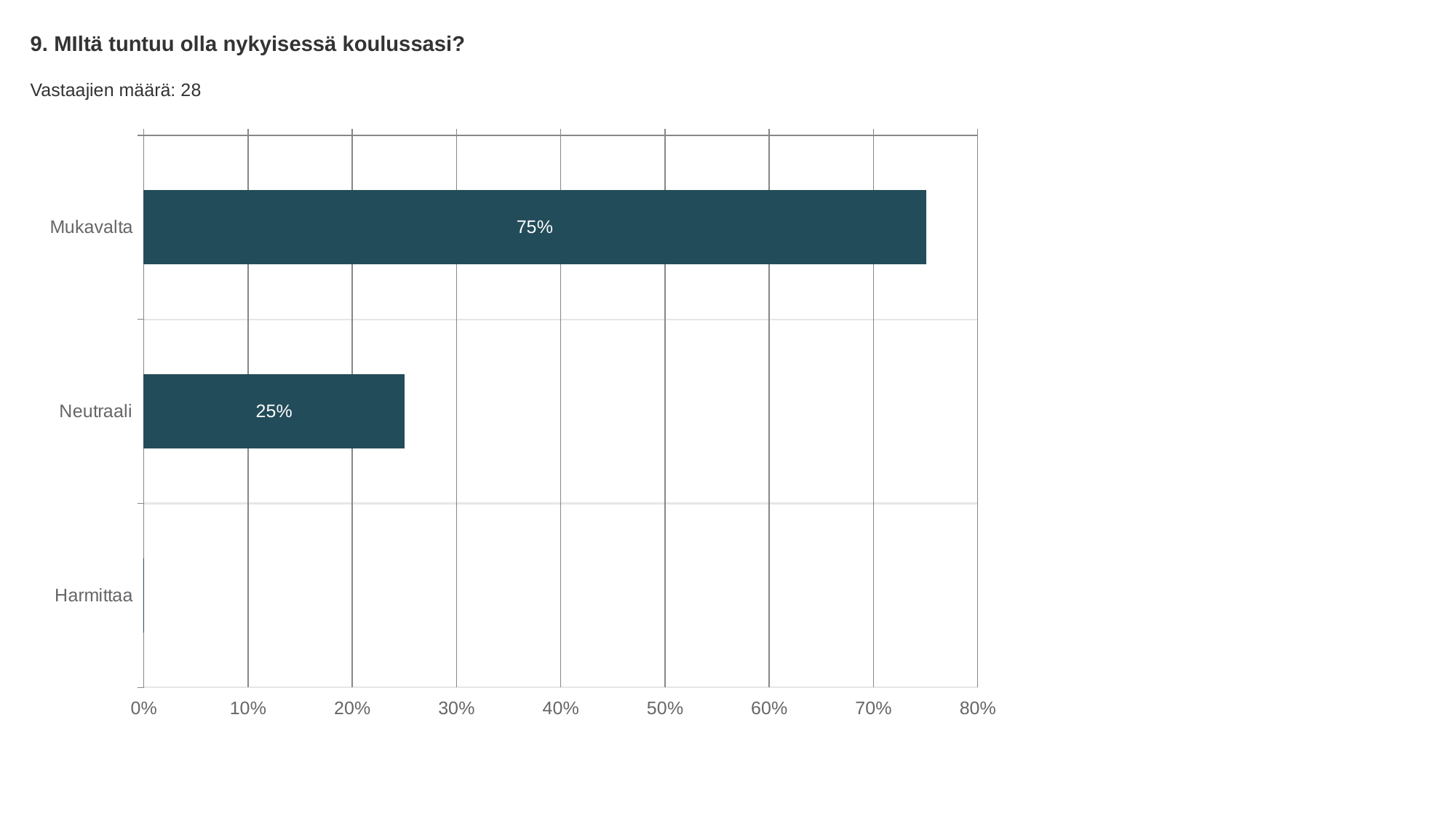
Which category has the highest value? Mukavalta Which category has the lowest value? Harmittaa What is the value for Mukavalta? 75% What is the difference between the values for Mukavalta and Neutraali? 50% How many categories are shown on the chart? 3 What kind of chart is shown on the slide? bar chart What is the title of the chart? 9. MIltä tuntuu olla nykyisessä koulussasi? Which is larger, the value for Mukavalta or the value for Neutraali? Mukavalta Is the value for Neutraali greater or less than 30%? less How many respondents does the slide report (Vastaajien määrä)? 28 What is the value for Neutraali? 25% Is the value for Mukavalta greater or less than 50%? greater